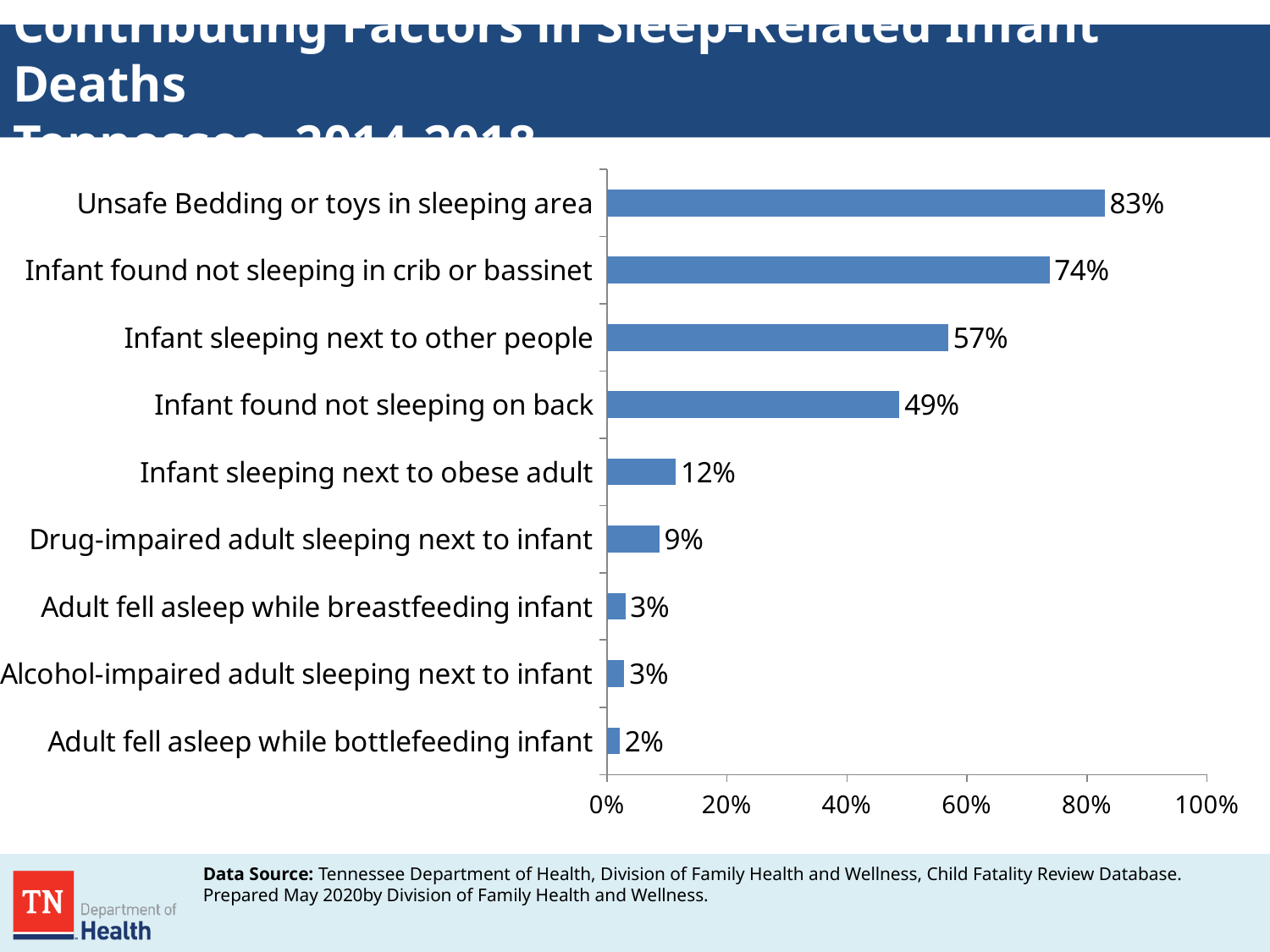
What is the value for "Infant found not sleeping on back"? 49% How many contributing factors are shown in the chart? 9 Which contributing factor has the highest percentage? Unsafe Bedding or toys in sleeping area What is the maximum value shown on the horizontal axis? 100% What is the difference between the highest and lowest values in the chart? 81% What is the difference between the values for "Infant found not sleeping in crib or bassinet" and "Infant sleeping next to other people"? 17% What percentage is shown for "Unsafe Bedding or toys in sleeping area"? 83% Which is larger: the value for "Infant sleeping next to obese adult" or "Drug-impaired adult sleeping next to infant"? Infant sleeping next to obese adult Is the value for "Infant found not sleeping on back" greater or less than 40%? greater What kind of chart is shown on the slide? Bar chart Which contributing factor has the lowest percentage? Adult fell asleep while bottlefeeding infant What percentage is shown for "Drug-impaired adult sleeping next to infant"? 9%